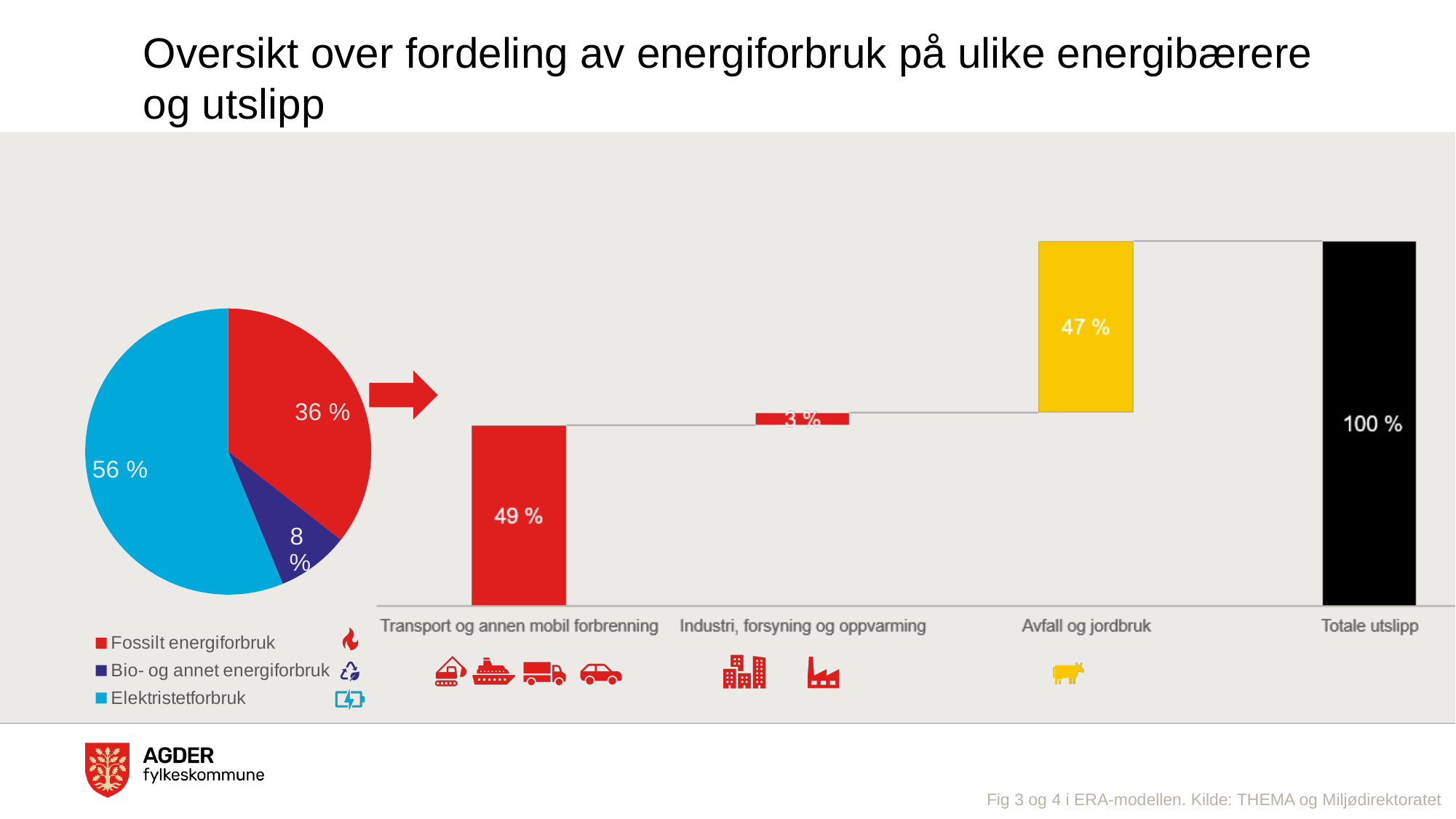
In the pie chart on the left, how many categories does the legend list? 3 In the pie chart on the left, what share is labelled for Fossilt energiforbruk? 36 % In the pie chart on the left, what share is labelled for Bio- og annet energiforbruk? 8 % In the bar chart on the right, what value is shown for Avfall og jordbruk? 47 % In the pie chart on the left, what share is labelled for Elektristetforbruk? 56 % In the bar chart on the right, what value is shown for Transport og annen mobil forbrenning? 49 % In the bar chart on the right, which of Transport og annen mobil forbrenning or Industri, forsyning og oppvarming has the larger value? Transport og annen mobil forbrenning In the pie chart on the left, which category has the largest slice? Elektristetforbruk In the pie chart on the left, which category has the smallest slice? Bio- og annet energiforbruk In the pie chart on the left, what is the difference between the Elektristetforbruk share and the Fossilt energiforbruk share? 20 % In the bar chart on the right, what value is shown for Industri, forsyning og oppvarming? 3 % In the bar chart on the right, what is the difference between the values for Transport og annen mobil forbrenning and Avfall og jordbruk? 2 %